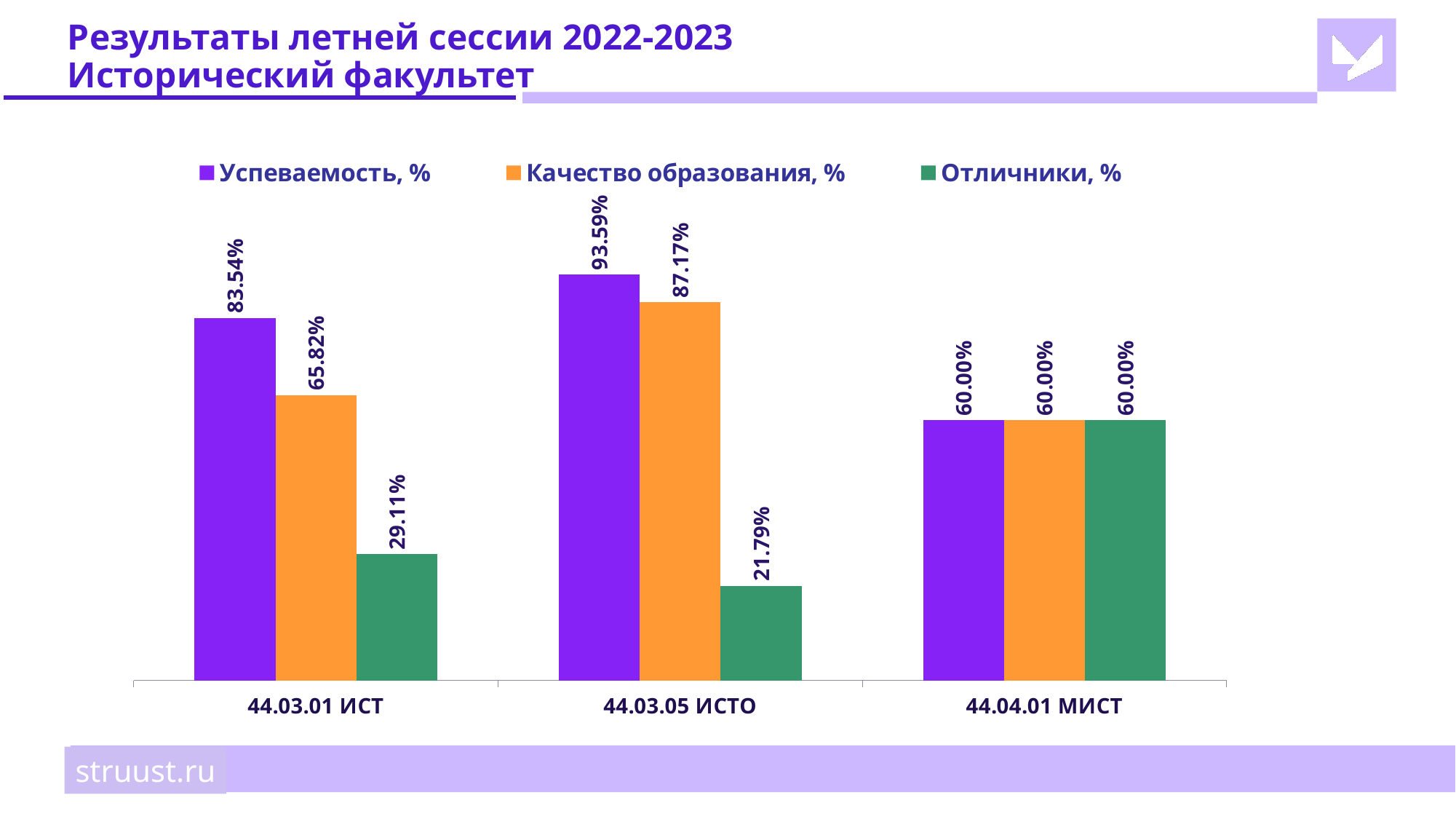
Which category has the lowest value of Отличники, %? 44.03.05 ИСТО What is the difference between Успеваемость, % and Качество образования, % for 44.03.01 ИСТ? 17.72% How many series does the legend list? 3 Which category has the highest value of Успеваемость, %? 44.03.05 ИСТО What is the value of Успеваемость, % for 44.03.01 ИСТ? 83.54% What kind of chart is shown on the slide? Bar chart Which is larger: Отличники, % for 44.03.01 ИСТ or Отличники, % for 44.03.05 ИСТО? 44.03.01 ИСТ What is the value of Отличники, % for 44.03.01 ИСТ? 29.11% How many categories are shown on the x axis? 3 What is the value of Качество образования, % for 44.03.05 ИСТО? 87.17% Which series is shown in orange in the legend? Качество образования, % What is the value of Отличники, % for 44.04.01 МИСТ? 60.00%